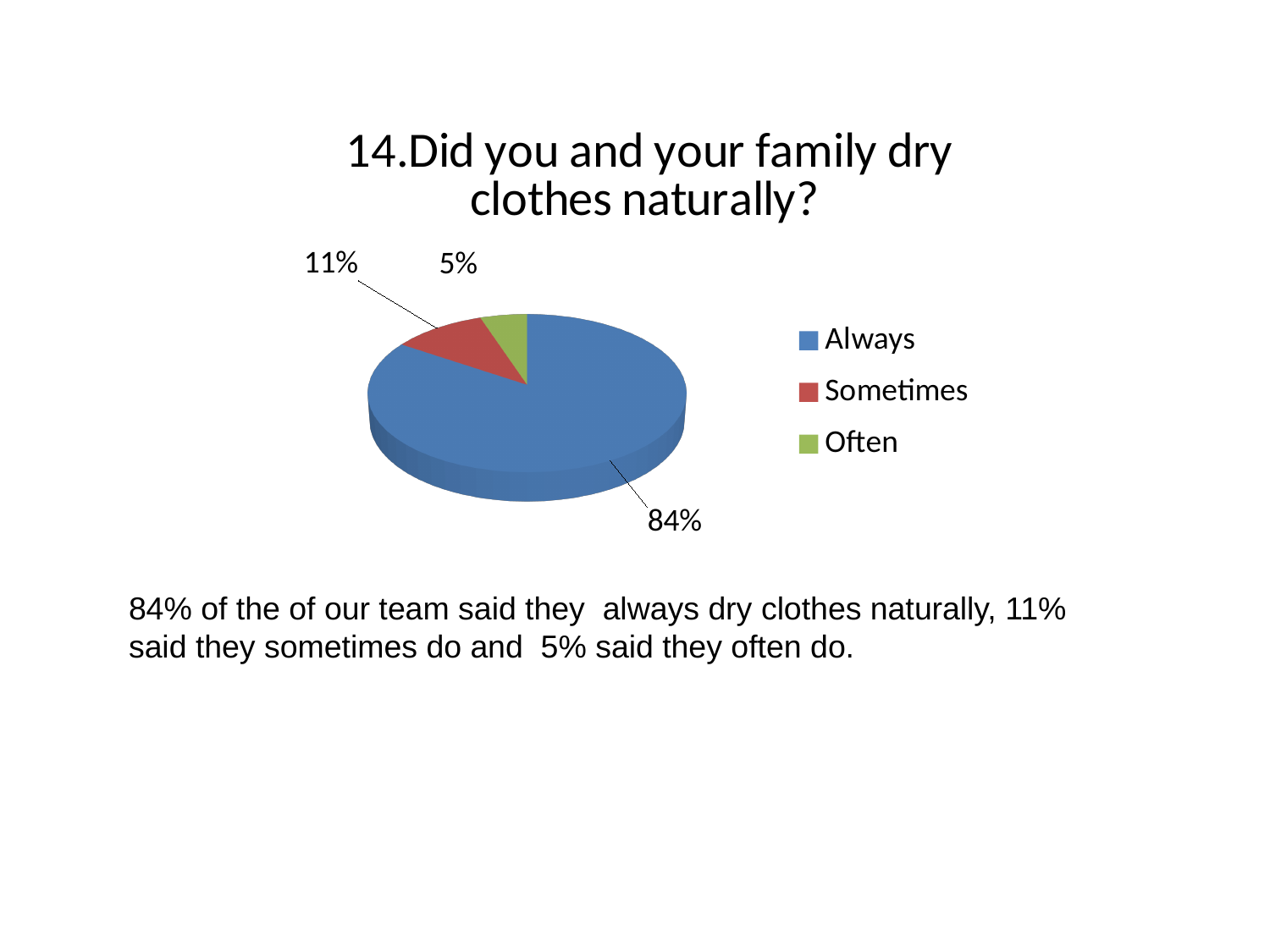
What share of the pie is labelled Always? 84% What kind of chart is shown on the slide? pie chart What is the difference in percentage points between the Always slice and the Sometimes slice? 73 What colour is the Sometimes slice in the pie chart? red How many categories does the pie chart have? 3 What share of the pie is labelled Sometimes? 11% Which category has the smallest slice of the pie? Often What is the title of the chart? 14.Did you and your family dry clothes naturally? Which category has the largest slice of the pie? Always What is the difference in percentage points between the Sometimes slice and the Often slice? 6 Which slice is larger, Sometimes or Often? Sometimes What share of the pie is labelled Often? 5%